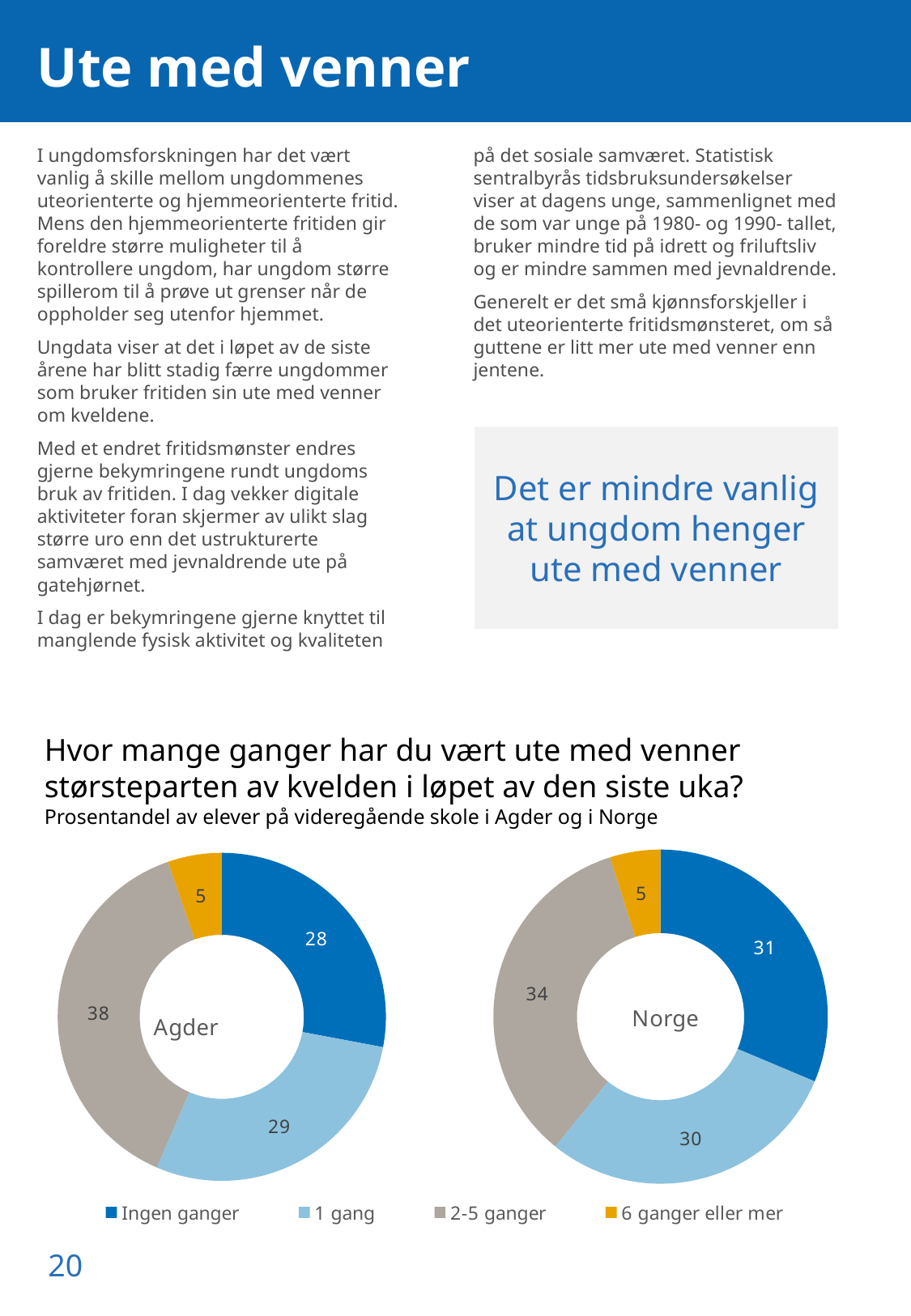
In the Agder chart, what is the difference between '1 gang' and 'Ingen ganger'? 1 Which colour represents '6 ganger eller mer' in the legend? Yellow/orange How many categories does each donut chart show? 4 What kind of chart is used for Agder and Norge? Donut (pie) chart In the Agder chart, which category has the largest share? 2-5 ganger In the Norge chart, what is the value for 'Ingen ganger'? 31 What is the difference between the '2-5 ganger' values in the Agder chart and the Norge chart? 4 In the Norge chart, what is the value for '1 gang'? 30 In the Norge chart, which category has the smallest share? 6 ganger eller mer In the Agder chart, what is the combined share of 'Ingen ganger' and '1 gang'? 57 In the Agder chart, what is the value for '2-5 ganger'? 38 Which chart has the larger value for 'Ingen ganger', Agder or Norge? Norge